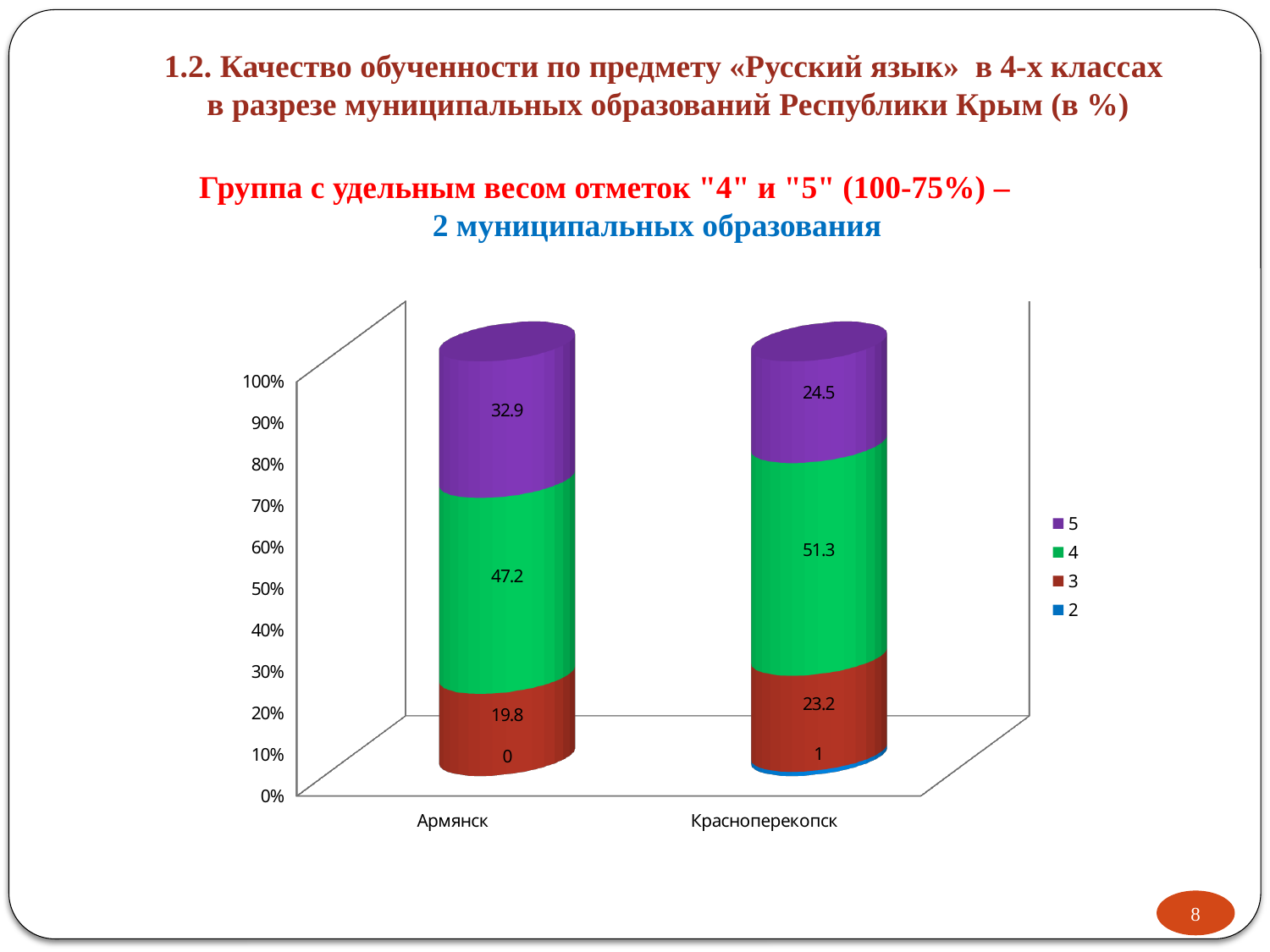
What is the value for series 3 for Армянск? 19.8 How many categories are shown on the x axis? 2 Which category has the higher value for series 5? Армянск What is the difference between the series 5 values for Армянск and Красноперекопск? 8.4 What is the value for series 5 for Армянск? 32.9 What is the value for series 2 for Красноперекопск? 1 Which category has the higher value for series 3? Красноперекопск What kind of chart is shown on the slide? Stacked bar chart Which series is shown in green in the legend? 4 How many series does the legend list? 4 What is the value for series 4 for Красноперекопск? 51.3 What is the difference between the series 4 values for Красноперекопск and Армянск? 4.1